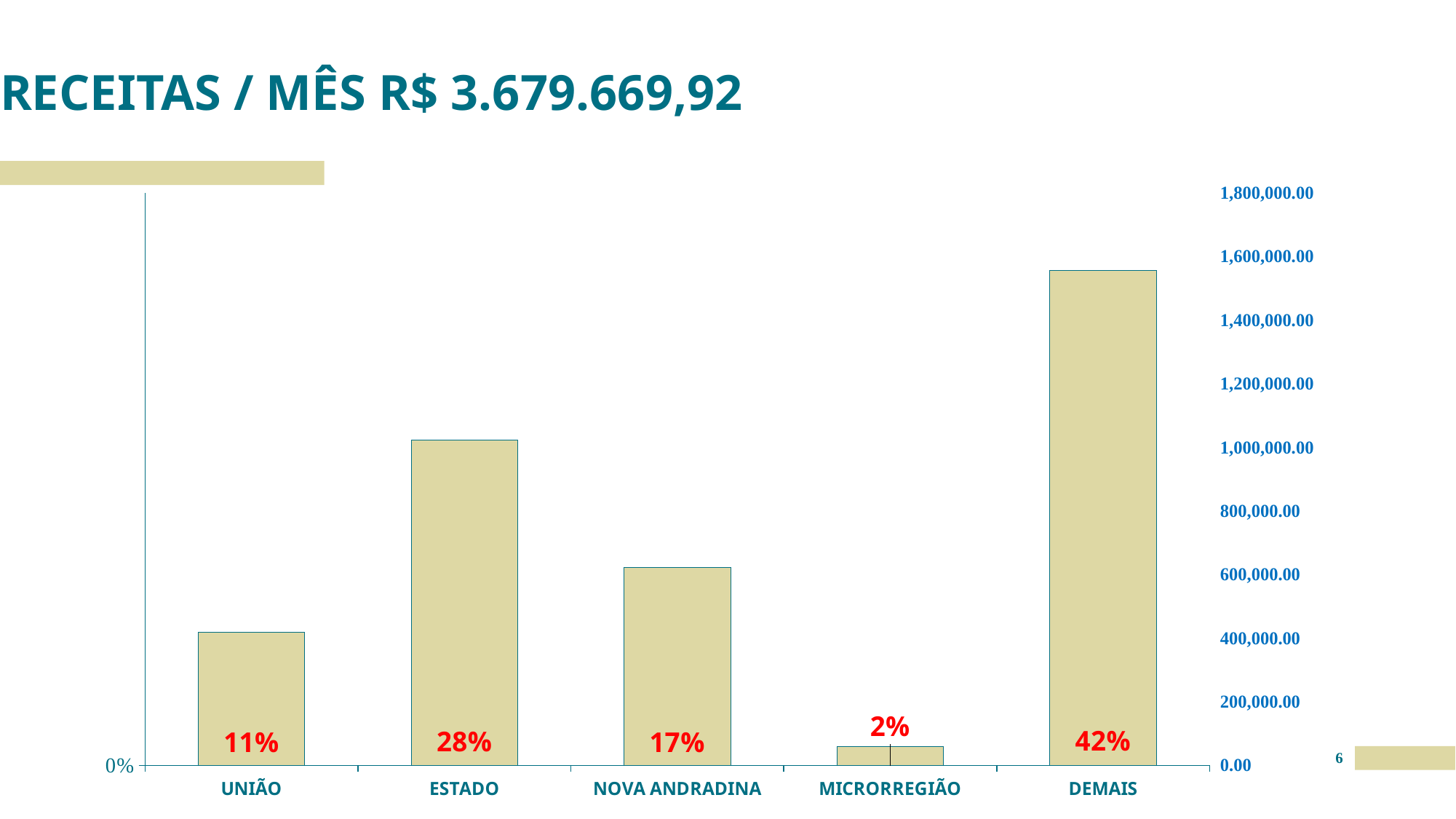
Which category has the highest bar? DEMAIS Which category has the lowest bar? MICRORREGIÃO Is the value for UNIÃO on the right-hand axis greater or less than 600,000.00? less Which bar is taller, ESTADO or NOVA ANDRADINA? ESTADO What percentage label is shown on the NOVA ANDRADINA bar? 17% Is the value for DEMAIS on the right-hand axis greater or less than 1,400,000.00? greater What percentage label is shown on the UNIÃO bar? 11% What percentage label is shown for MICRORREGIÃO? 2% What percentage label is shown on the ESTADO bar? 28% What is the difference in percentage points between the DEMAIS label and the ESTADO label? 14 How many categories are shown on the x axis? 5 What type of chart is shown on the slide? Bar chart